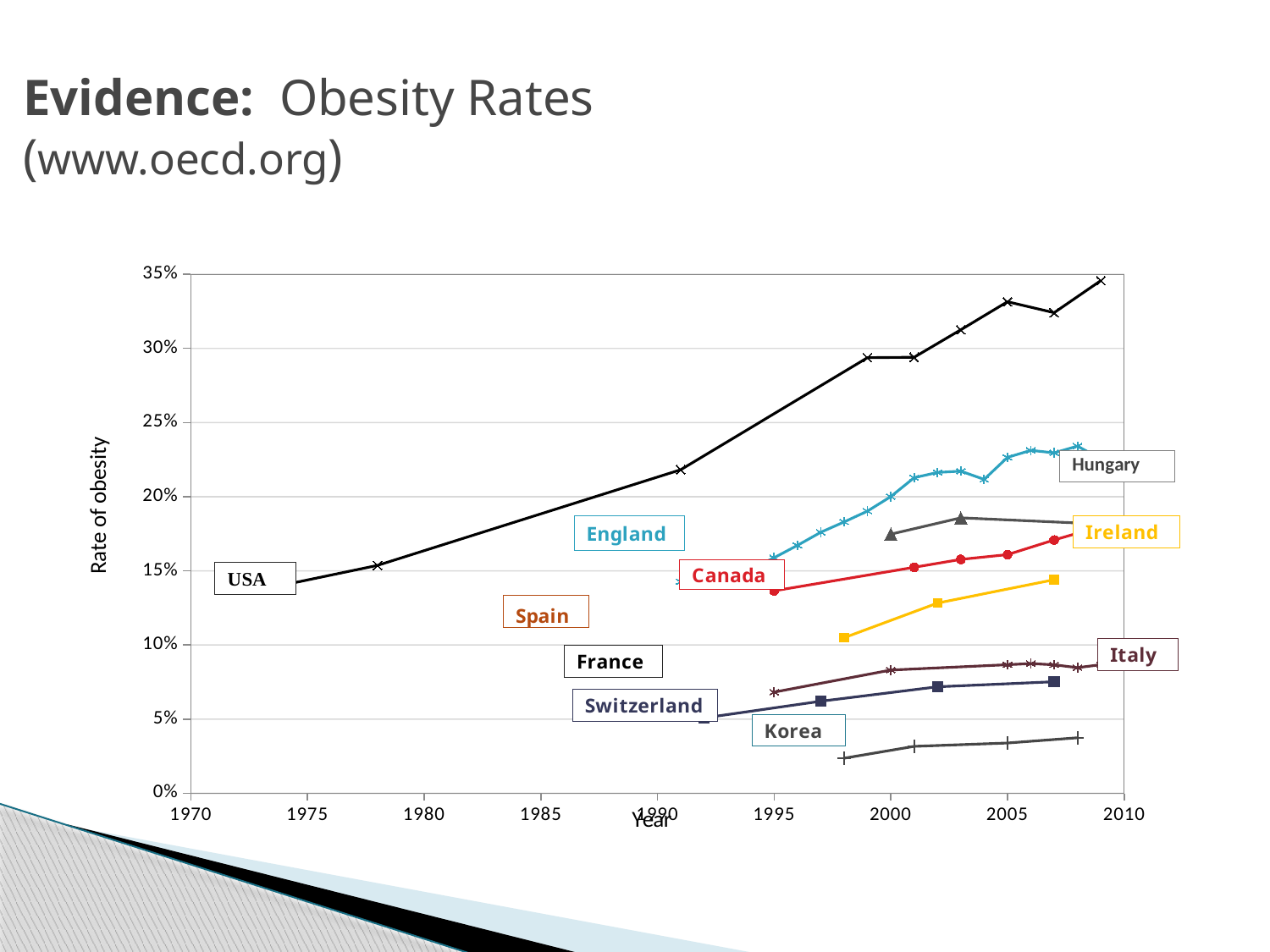
Which country has the highest rate of obesity on the chart? USA Which has the higher rate of obesity in 2007, Switzerland or Korea? Switzerland What is the label on the vertical axis of the chart? Rate of obesity Is the USA's rate of obesity in 2009 greater or less than 30%? greater How many countries are labelled on the chart? 10 Is England's rate of obesity in 2008 greater or less than 20%? greater Is Korea's rate of obesity in 2008 greater or less than 5%? less Which country has the lowest rate of obesity on the chart? Korea Which has the higher rate of obesity in 2007, Canada or Ireland? Canada What kind of chart is shown on the slide? line chart Does the USA's rate of obesity rise or fall from 1975 to 2009? rise